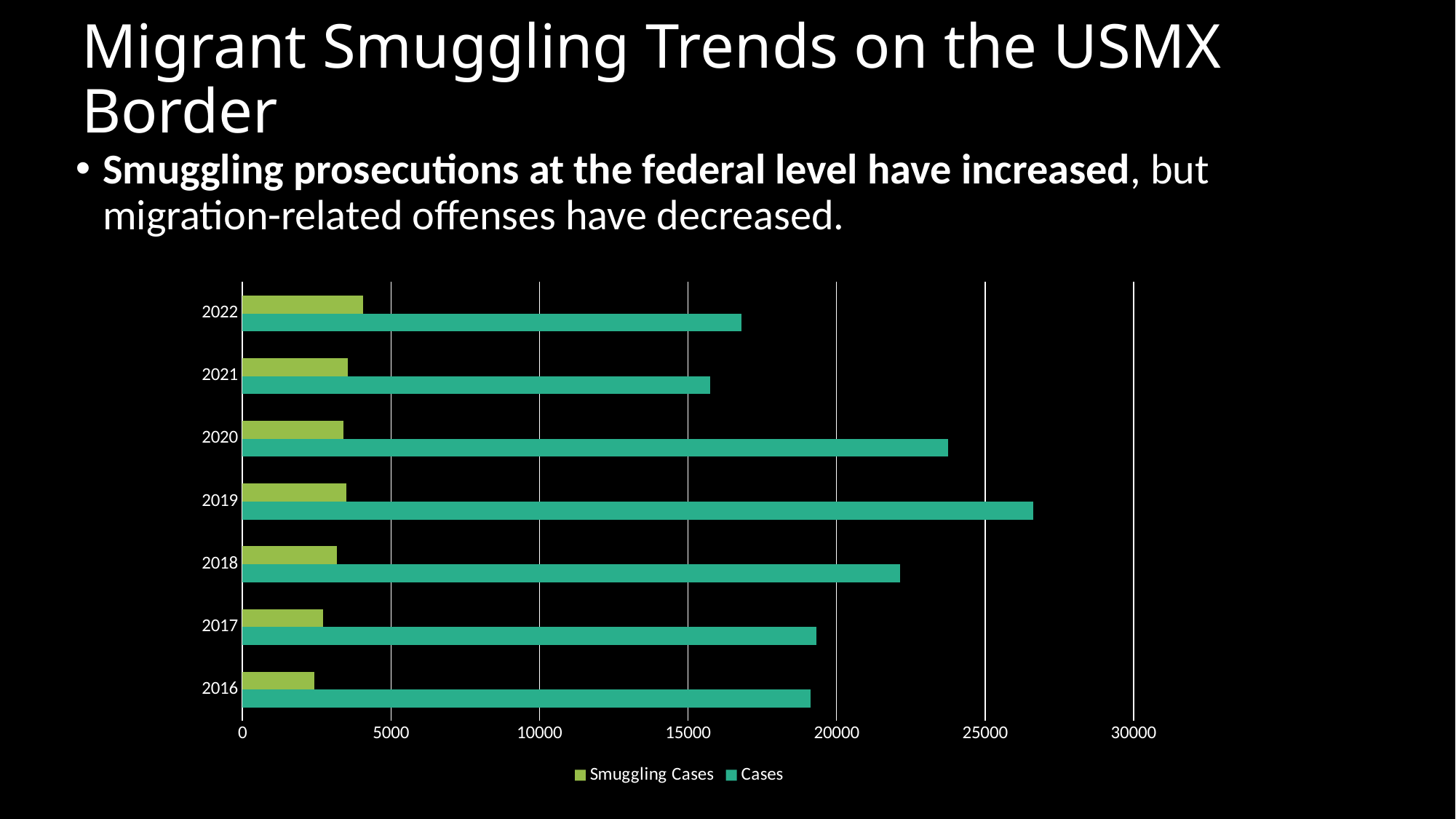
What are the two series named in the legend? Smuggling Cases and Cases Which year has the lowest value for Smuggling Cases? 2016 Which year has the larger value for Cases, 2020 or 2018? 2020 Is the value for Cases in 2021 greater or less than 20000? less Which year has the highest value for Cases? 2019 What kind of chart is shown on the slide? Bar chart How many years are shown on the chart? 7 Which year has the lowest value for Cases? 2021 Is the value for Cases in 2019 greater or less than 25000? greater Which year has the highest value for Smuggling Cases? 2022 How many series does the legend list? 2 Is the value for Smuggling Cases in 2022 greater or less than 5000? less